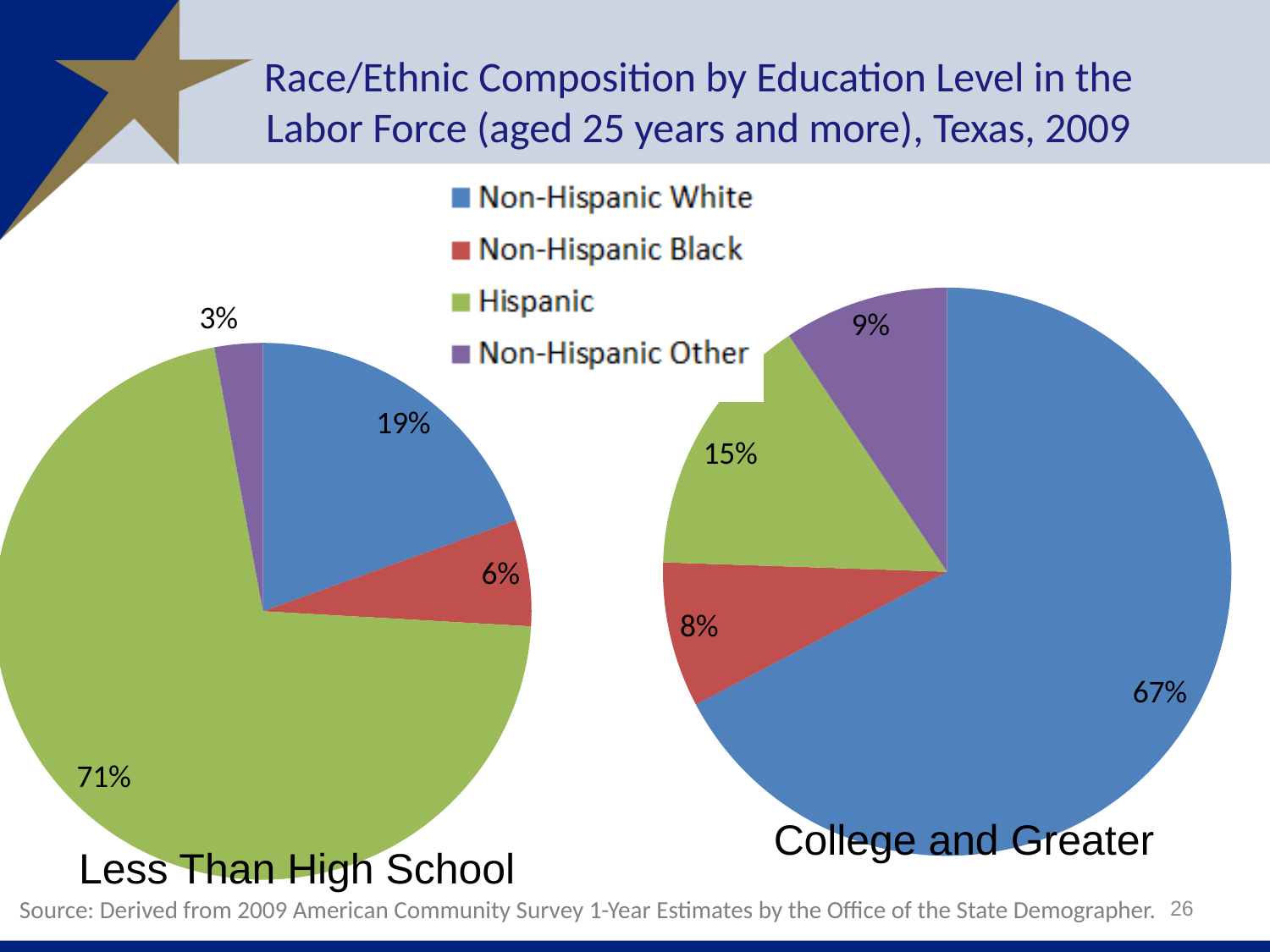
What is the difference between the Non-Hispanic White share in the College and Greater chart and in the Less Than High School chart? 48% How many slices does the Less Than High School pie chart have? 4 How many groups does the legend list? 4 In the Less Than High School pie chart, which group has the smallest share? Non-Hispanic Other In the Less Than High School pie chart, which group has the largest share? Hispanic In the College and Greater pie chart, which is larger: the Hispanic share or the Non-Hispanic Other share? Hispanic In the Less Than High School pie chart, what share is Non-Hispanic Black? 6% What type of chart is used on this slide? Pie chart In the College and Greater pie chart, what share is Non-Hispanic Other? 9% In the College and Greater pie chart, which group has the smallest share? Non-Hispanic Black In the College and Greater pie chart, what share is Non-Hispanic White? 67% In the Less Than High School pie chart, what share is Hispanic? 71%